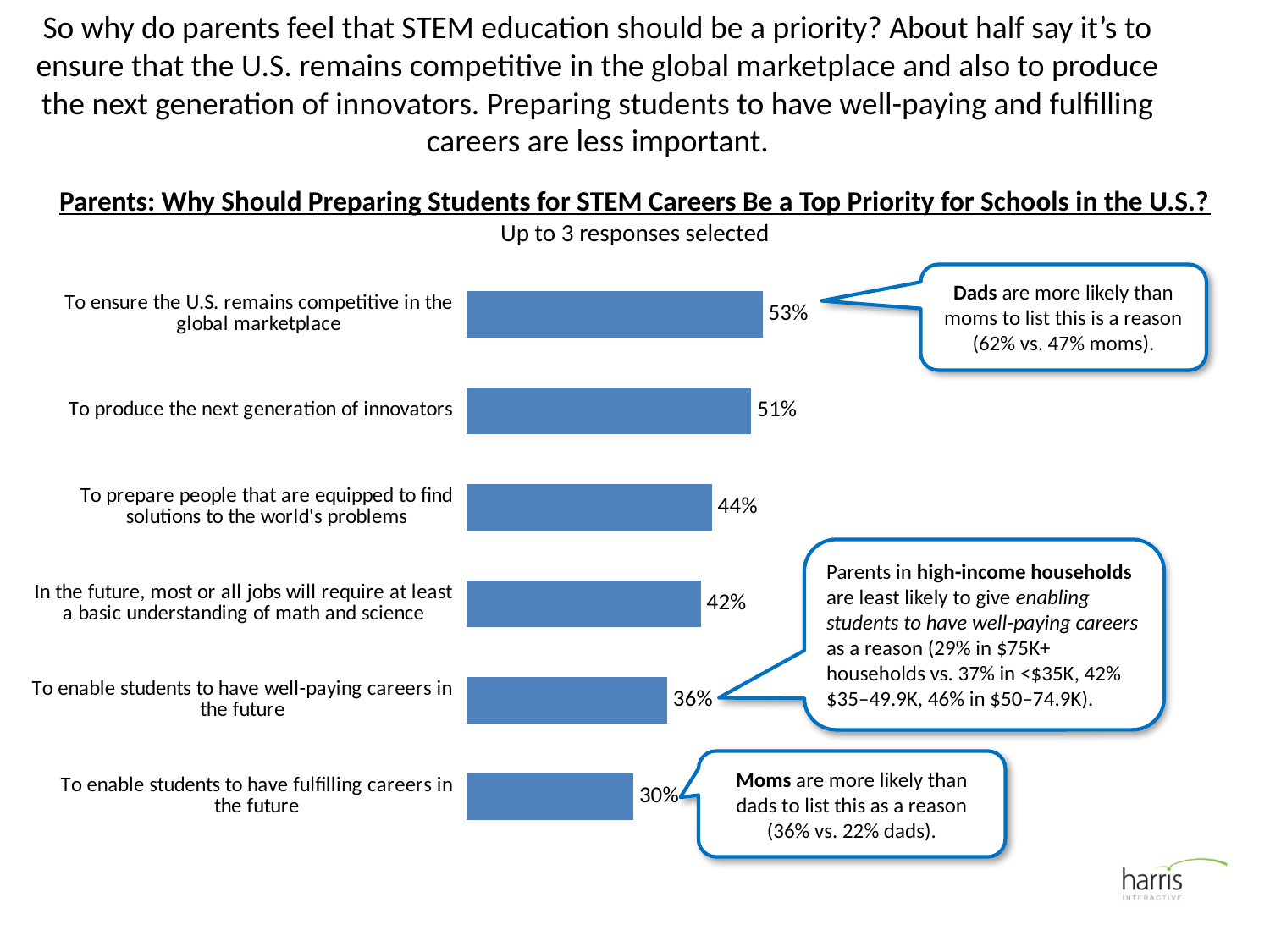
What percentage of parents selected "To ensure the U.S. remains competitive in the global marketplace"? 53% Which is larger: the value for "To produce the next generation of innovators" or the value for "To prepare people that are equipped to find solutions to the world's problems"? To produce the next generation of innovators What is the value for "In the future, most or all jobs will require at least a basic understanding of math and science"? 42% What is the value for "To enable students to have fulfilling careers in the future"? 30% According to the subtitle under the chart title, how many responses could each parent select? Up to 3 responses How many reasons (categories) are shown in the chart? 6 What type of chart is shown on the slide? Bar chart What percentage of parents selected "To produce the next generation of innovators"? 51% What is the difference between the highest and lowest values in the chart? 23 percentage points Which reason has the lowest percentage? To enable students to have fulfilling careers in the future What is the difference in percentage points between "To prepare people that are equipped to find solutions to the world's problems" and "To enable students to have well-paying careers in the future"? 8 percentage points Which reason has the highest percentage? To ensure the U.S. remains competitive in the global marketplace